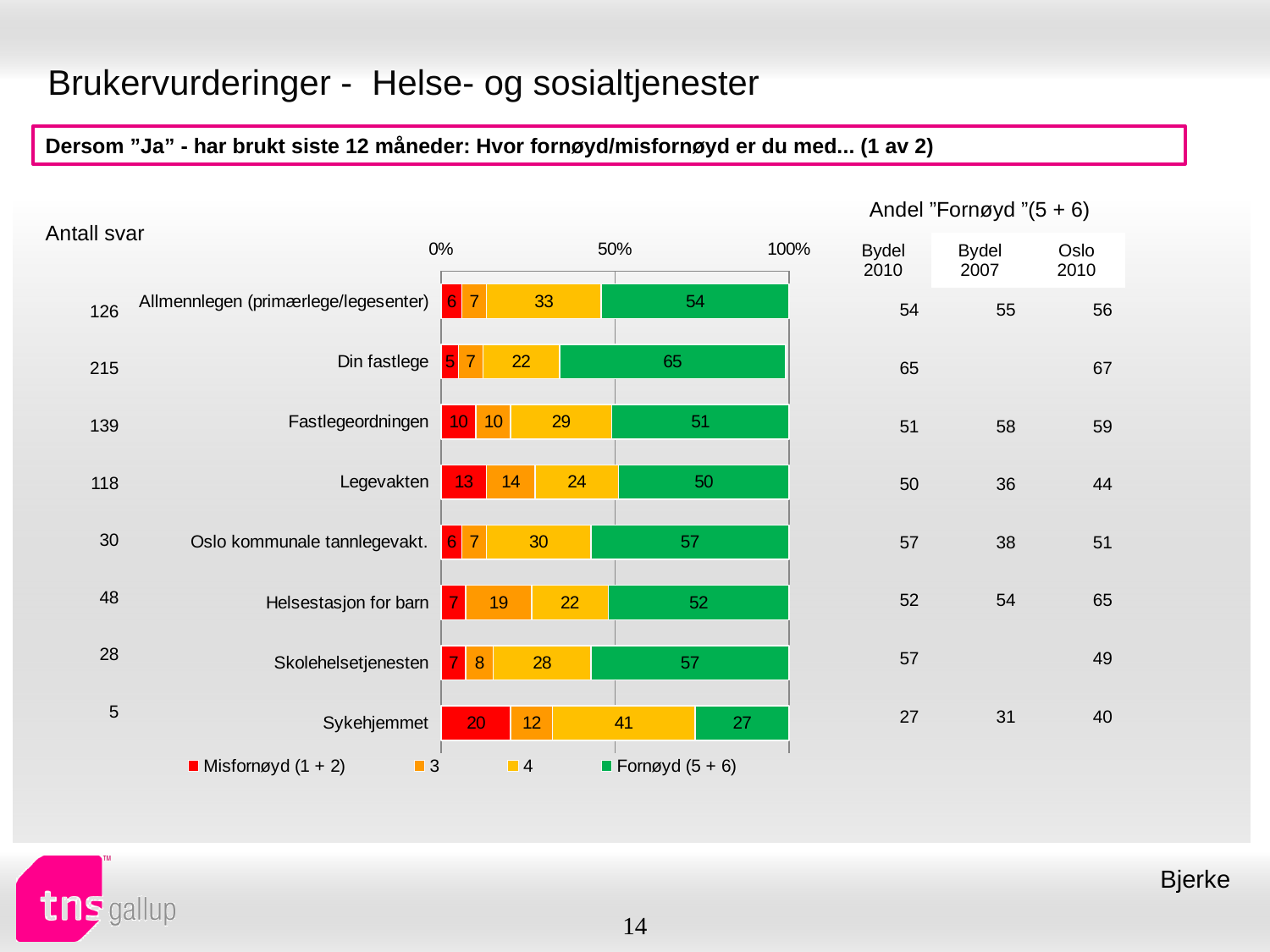
What is the value of the Misfornøyd (1 + 2) segment for Legevakten? 13 What is the value of the '4' segment for Sykehjemmet? 41 What is the value of the Fornøyd (5 + 6) segment for Din fastlege? 65 What kind of chart is shown on the slide? Stacked bar chart How many categories are shown in the bar chart? 8 Which category has the highest Fornøyd (5 + 6) value? Din fastlege How many series does the legend list? 4 What is the difference between the Fornøyd (5 + 6) values for Din fastlege and Sykehjemmet? 38 Which has a larger Fornøyd (5 + 6) value, Legevakten or Skolehelsetjenesten? Skolehelsetjenesten What is the total of the stacked bar for Allmennlegen (primærlege/legesenter)? 100 Which category has the lowest Fornøyd (5 + 6) value? Sykehjemmet Which category has the highest Misfornøyd (1 + 2) value? Sykehjemmet